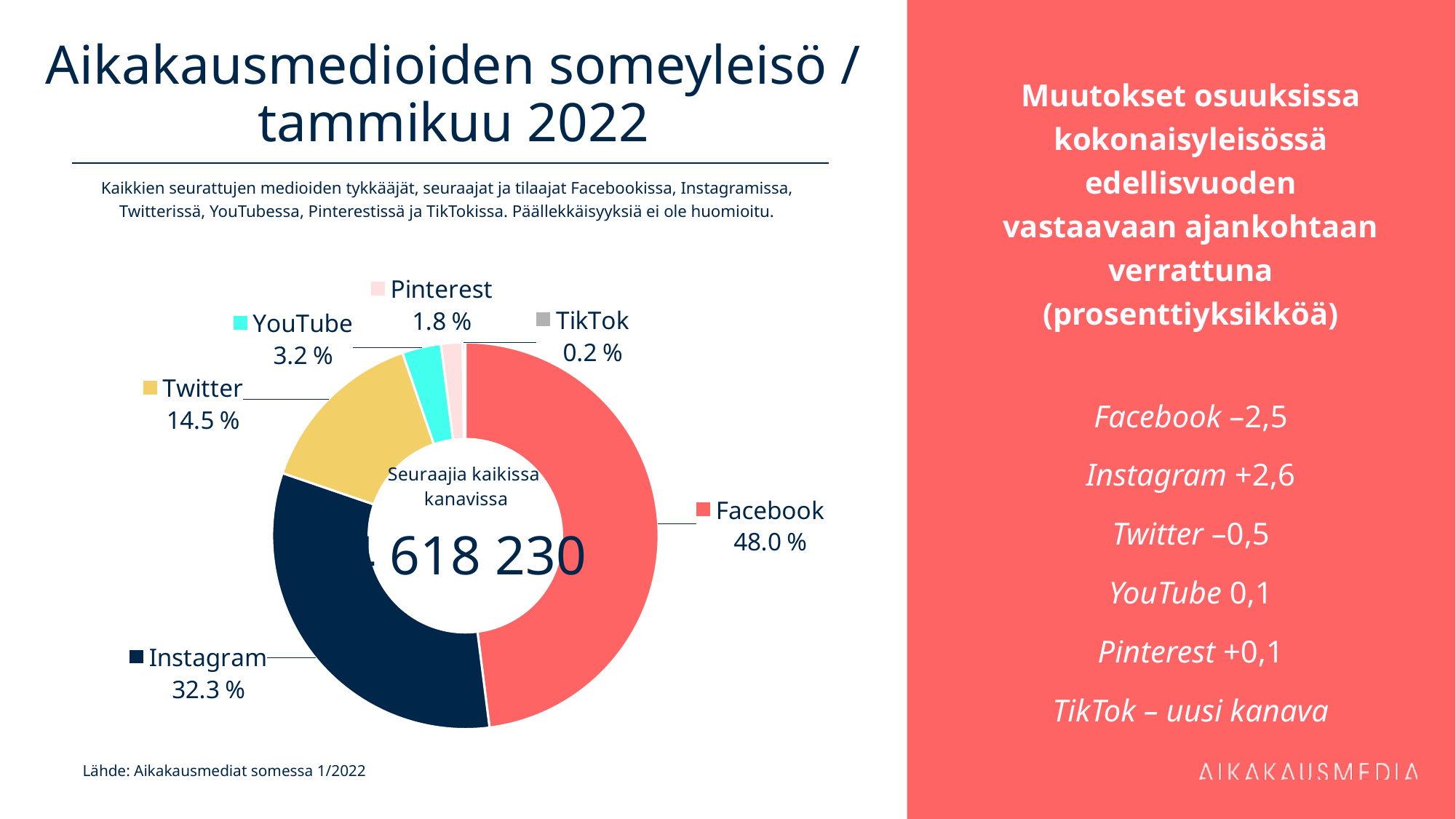
What colour is the Twitter slice in the chart? Yellow What is the difference in percentage points between Facebook's and Instagram's shares? 15.7 Which channel has the largest share of the audience? Facebook Which channel has the smallest share of the audience? TikTok What share of the social media audience does Twitter hold? 14.5 % What share of the social media audience does TikTok hold? 0.2 % What share of the social media audience does Facebook hold? 48.0 % What is the combined share of Twitter and YouTube? 17.7 % Which has a larger share, YouTube or Pinterest? YouTube What type of chart is used on the slide? Donut (pie) chart How many channels are shown in the chart? 6 What share of the social media audience does Instagram hold? 32.3 %